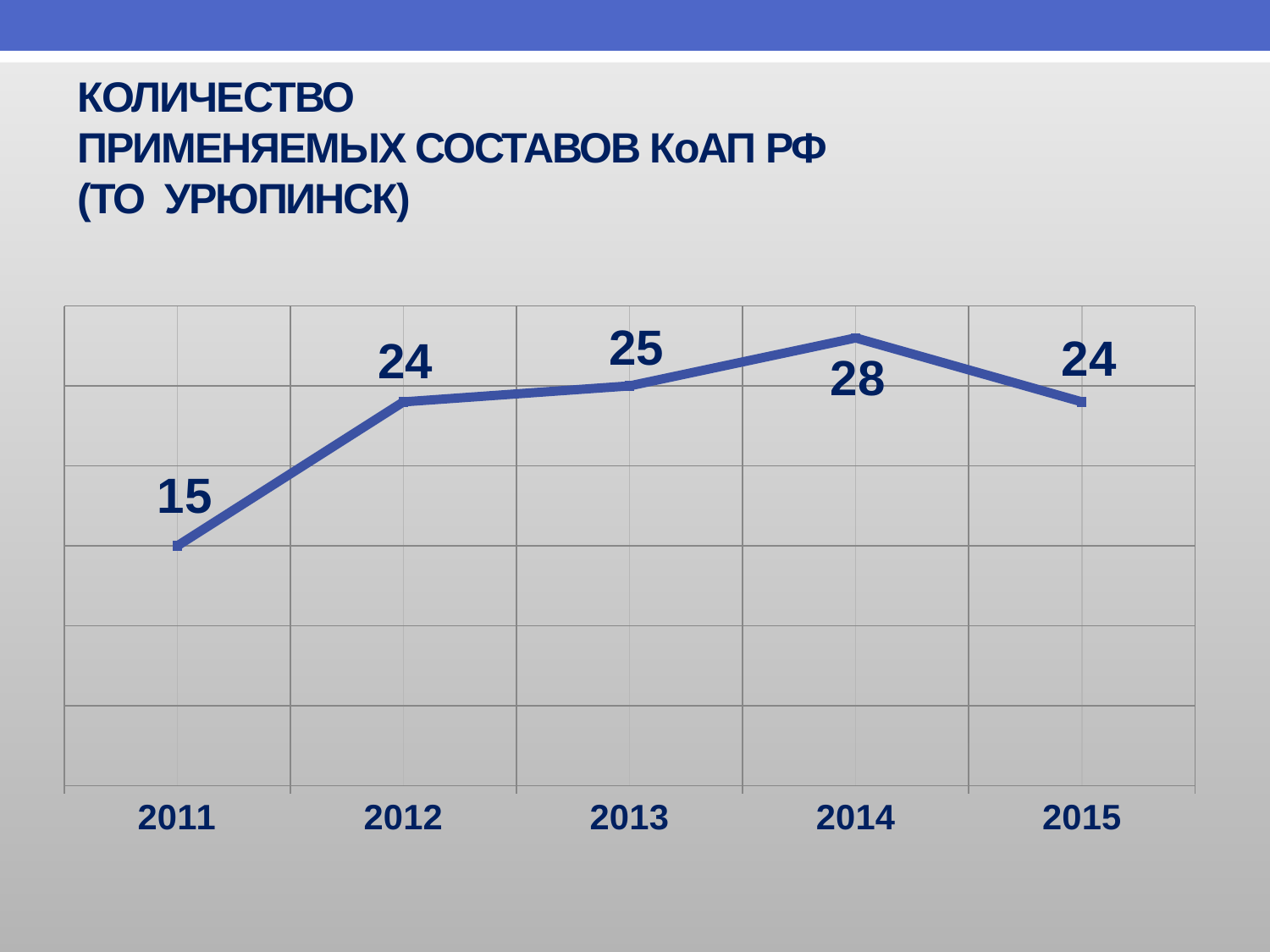
What is the value for 2014? 28 Which year has the highest value? 2014 What is the difference between the values for 2012 and 2011? 9 What kind of chart is shown on the slide? line chart What is the value for 2013? 25 Does the value rise or fall from 2014 to 2015? fall Which is larger, the value for 2013 or the value for 2015? 2013 Which year has the lowest value? 2011 What is the difference between the values for 2014 and 2011? 13 What is the value for 2011? 15 How many years are plotted on the chart? 5 What is the value for 2015? 24